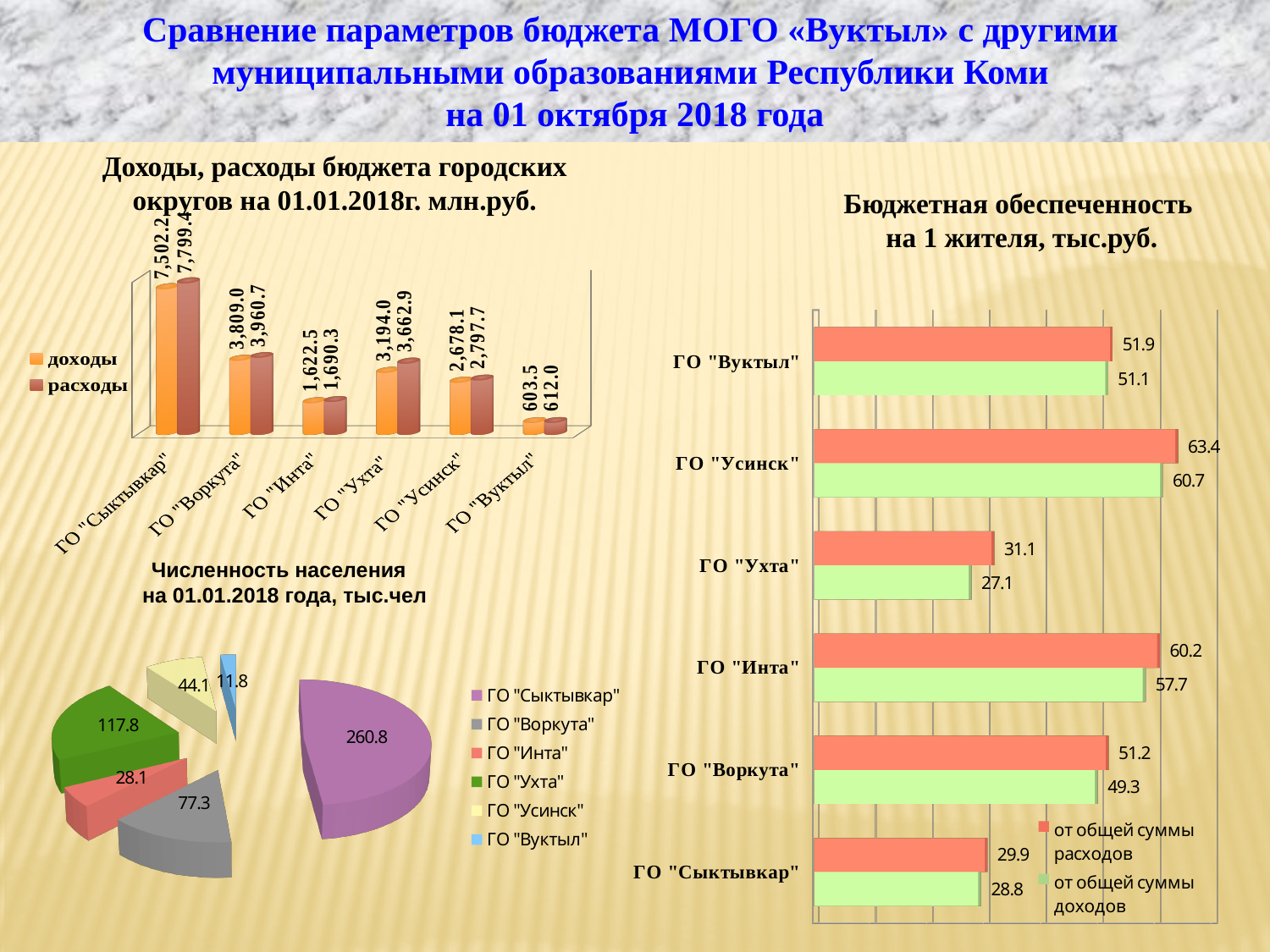
In the chart 'Численность населения на 01.01.2018 года, тыс.чел', which city district has the smallest slice? ГО "Вуктыл" In the chart 'Доходы, расходы бюджета городских округов на 01.01.2018г. млн.руб.', how many series does the legend list? 2 In the chart 'Доходы, расходы бюджета городских округов на 01.01.2018г. млн.руб.', what is the расходы value for ГО "Ухта"? 3,662.9 In the chart 'Бюджетная обеспеченность на 1 жителя, тыс.руб.', how many city districts are shown? 6 In the chart 'Численность населения на 01.01.2018 года, тыс.чел', what is the value for ГО "Ухта"? 117.8 In the chart 'Доходы, расходы бюджета городских округов на 01.01.2018г. млн.руб.', which city district has the highest расходы? ГО "Сыктывкар" What kind of chart is 'Численность населения на 01.01.2018 года, тыс.чел'? Pie chart In the chart 'Доходы, расходы бюджета городских округов на 01.01.2018г. млн.руб.', what is the difference between расходы and доходы for ГО "Вуктыл"? 8.5 In the chart 'Бюджетная обеспеченность на 1 жителя, тыс.руб.', what is the difference between 'от общей суммы расходов' and 'от общей суммы доходов' for ГО "Ухта"? 4.0 In the chart 'Доходы, расходы бюджета городских округов на 01.01.2018г. млн.руб.', what is the доходы value for ГО "Вуктыл"? 603.5 In the chart 'Бюджетная обеспеченность на 1 жителя, тыс.руб.', what is the value 'от общей суммы доходов' for ГО "Инта"? 57.7 In the chart 'Бюджетная обеспеченность на 1 жителя, тыс.руб.', which city district has the highest value 'от общей суммы расходов'? ГО "Усинск"